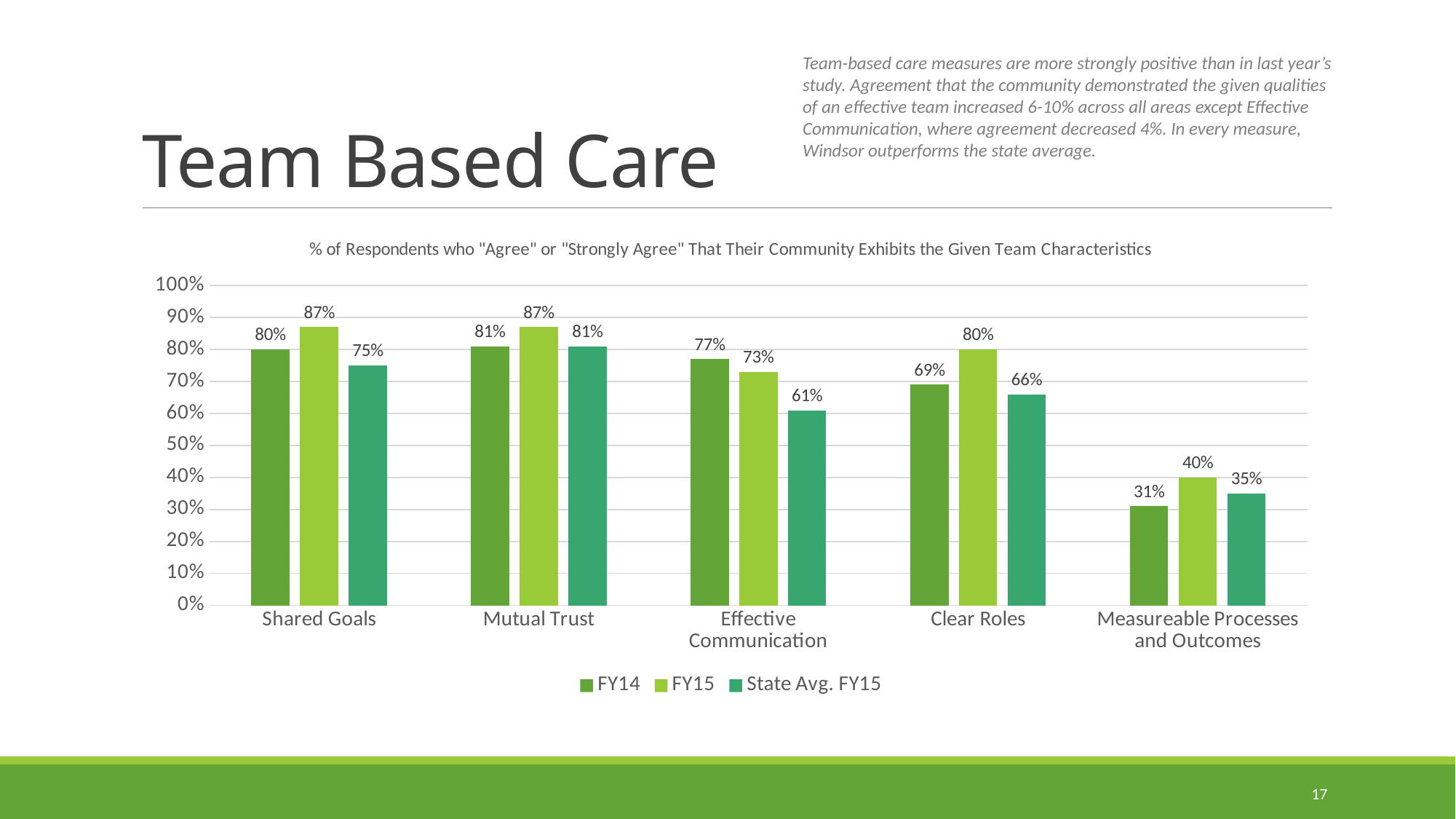
Which is larger for Effective Communication, the FY14 value or the FY15 value? FY14 Which category has the lowest FY15 value? Measureable Processes and Outcomes What is the FY15 value for Clear Roles? 80% What is the FY14 value for Measureable Processes and Outcomes? 31% What is the difference between the FY15 value and the State Avg. FY15 value for Clear Roles? 14% Which category has the highest State Avg. FY15 value? Mutual Trust What is the State Avg. FY15 value for Effective Communication? 61% What kind of chart is shown on the slide? Bar chart How many series does the legend list? 3 How many categories are shown on the x axis? 5 What are the three series listed in the legend? FY14, FY15, State Avg. FY15 What is the difference between the FY15 and FY14 values for Shared Goals? 7%